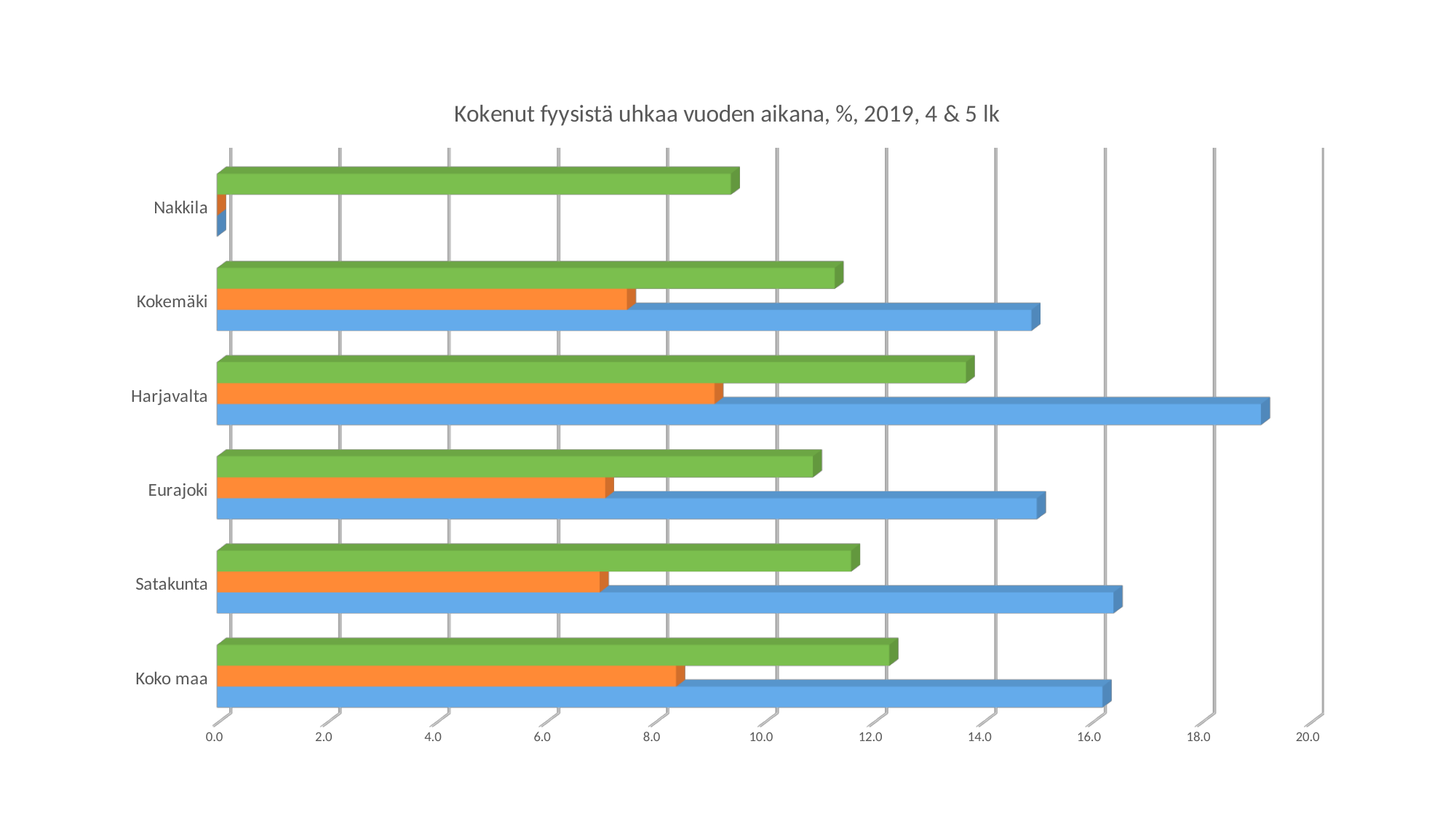
What kind of chart is shown on the slide? bar chart Which category has the longest green bar? Harjavalta How many bars are plotted for the Harjavalta category? 3 Is the value of the orange bar for Koko maa greater or less than 6.0? greater Is the value of the green bar for Nakkila greater or less than 10.0? less Which category has the shortest green bar? Nakkila Is the value of the blue bar for Harjavalta greater or less than 18.0? greater Which category has the longest blue bar? Harjavalta What is the title of the chart? Kokenut fyysistä uhkaa vuoden aikana, %, 2019, 4 & 5 lk Which is larger, the blue bar for Harjavalta or the blue bar for Eurajoki? Harjavalta Which is larger, the green bar for Harjavalta or the green bar for Kokemäki? Harjavalta How many categories are shown on the vertical axis of the chart? 6